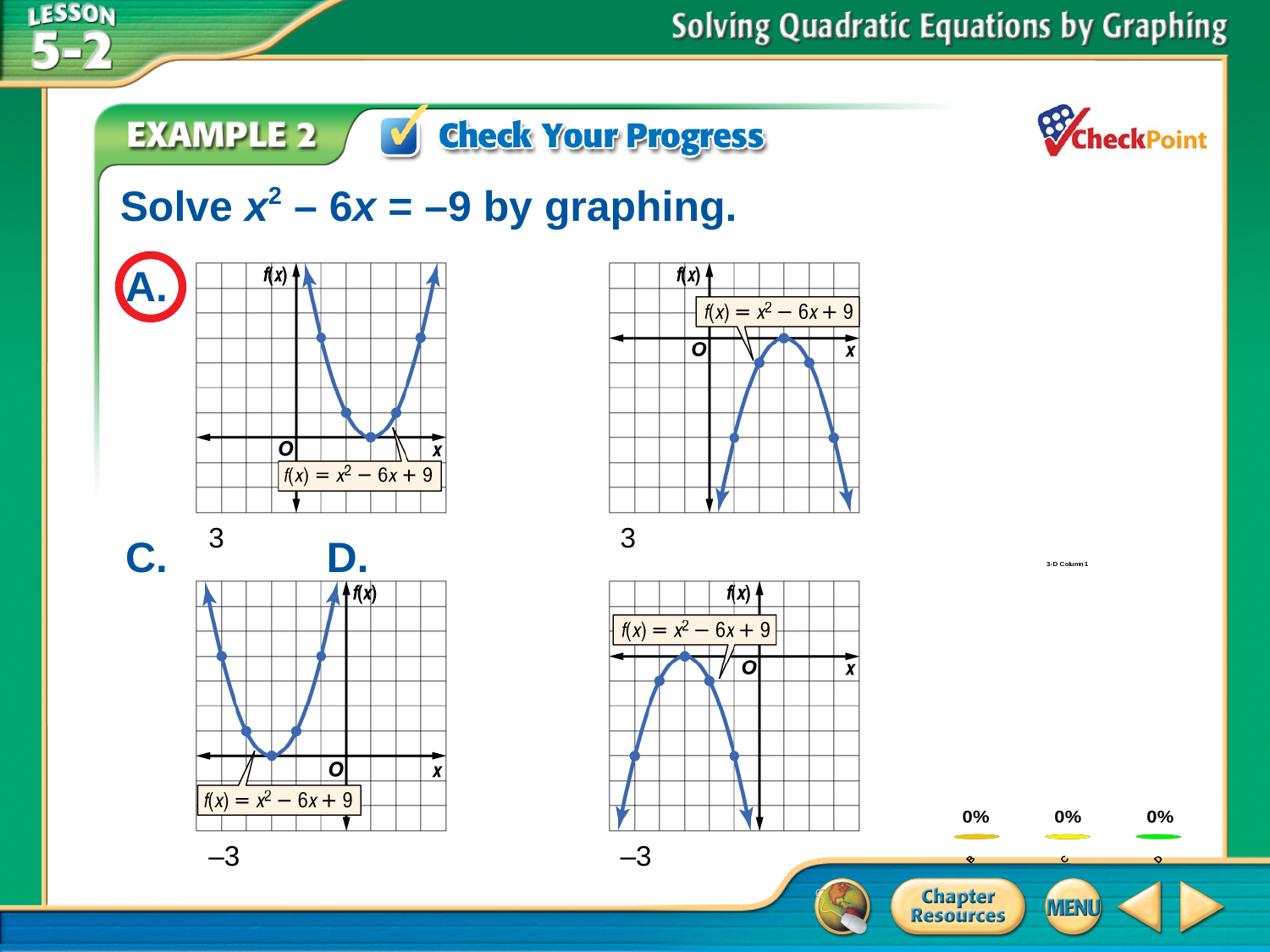
What value is labelled above the middle bar of the bottom-right chart? 0% Do all three bars of the bottom-right chart show the same labelled value? yes What value is labelled above the rightmost bar of the bottom-right chart? 0% How many bars does the small chart in the bottom right corner have? 3 Which answer choice on the slide is circled in red? A What value is labelled above the leftmost bar of the bottom-right chart? 0% What kind of chart is shown in the bottom right corner of the slide? bar chart